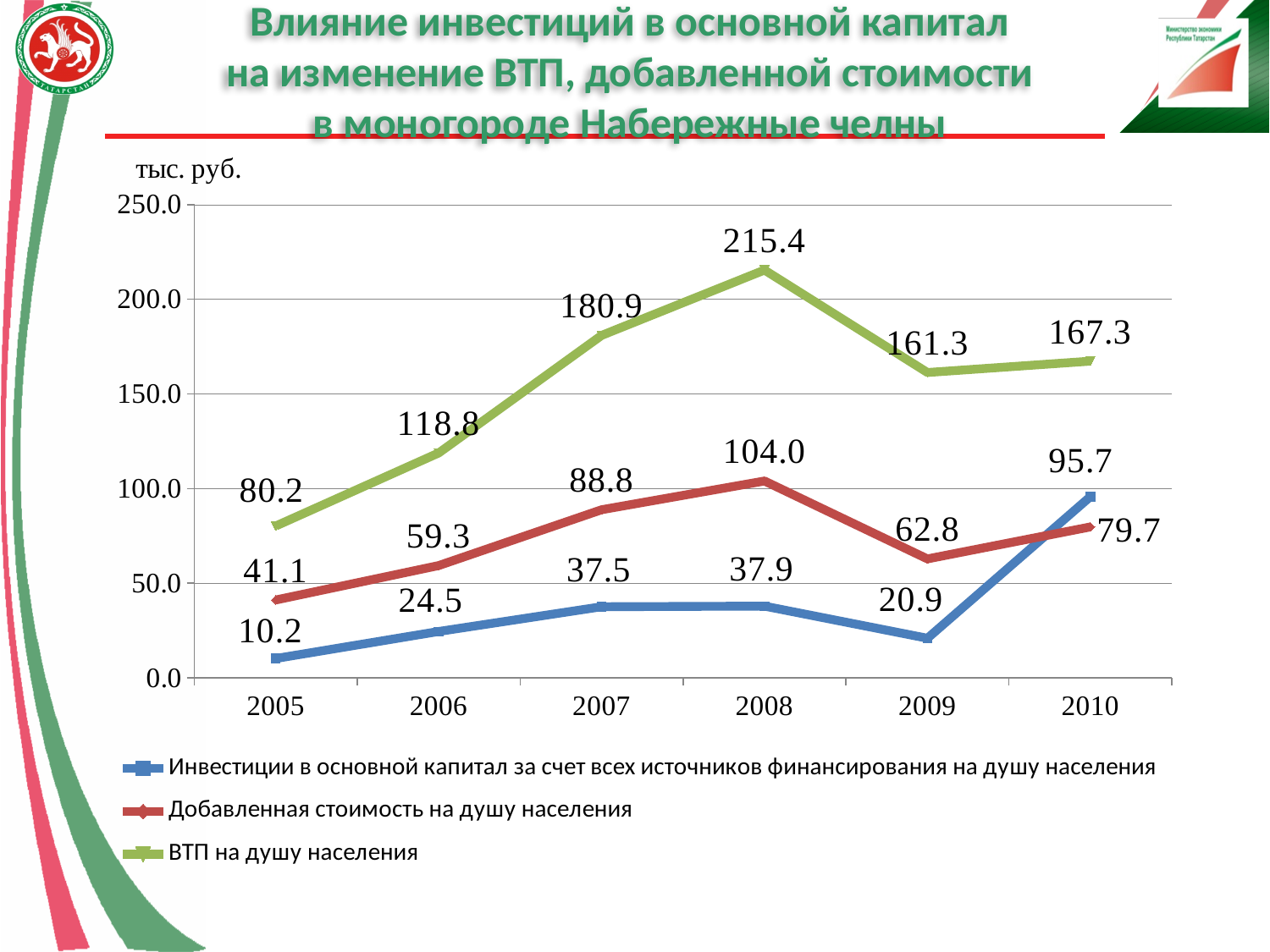
In which year is ВТП на душу населения highest? 2008 In which year is Инвестиции в основной капитал на душу населения lowest? 2005 What is the value of Добавленная стоимость на душу населения in 2009? 62.8 What unit is shown above the y axis? тыс. руб. What is the value of Инвестиции в основной капитал за счет всех источников финансирования на душу населения in 2010? 95.7 What is the value of ВТП на душу населения in 2008? 215.4 How many years are shown on the x axis? 6 Which is larger in 2010: Инвестиции в основной капитал на душу населения or Добавленная стоимость на душу населения? Инвестиции в основной капитал на душу населения What type of chart is shown on the slide? line chart How many series does the legend list? 3 What is the difference between ВТП на душу населения in 2008 and in 2009? 54.1 Does ВТП на душу населения rise or fall from 2005 to 2008? rise